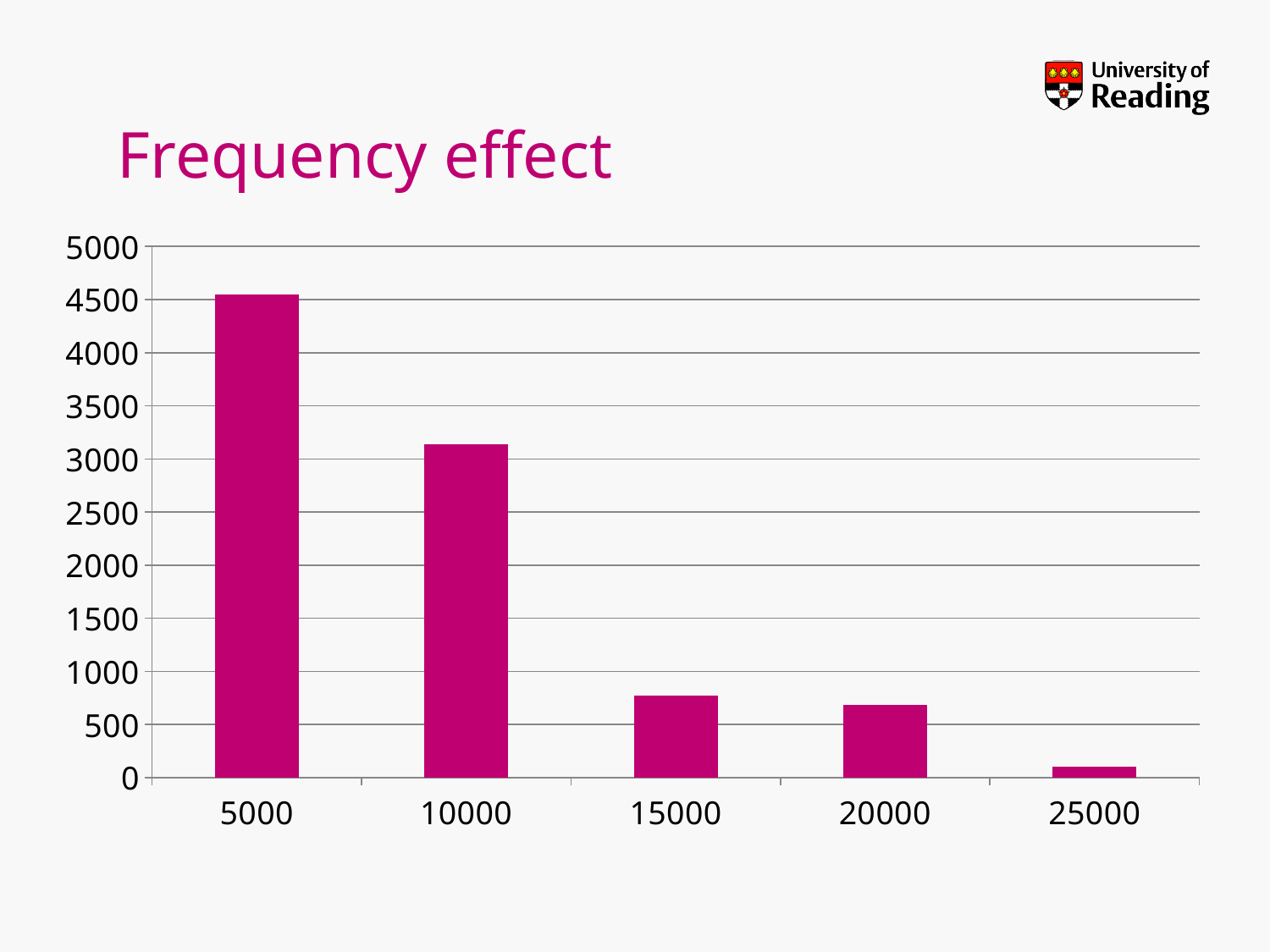
Which is larger, the value for 10000 or the value for 15000? 10000 Is the value for 25000 greater or less than 500? less Is the value for 20000 greater or less than 500? greater What kind of chart is shown on the slide? bar chart What is the title of the slide? Frequency effect Do the values rise or fall as you move from 5000 to 25000 along the x axis? fall Which category has the highest bar? 5000 Is the value for 5000 greater or less than 4000? greater Which category has the lowest bar? 25000 How many bars are plotted in the chart? 5